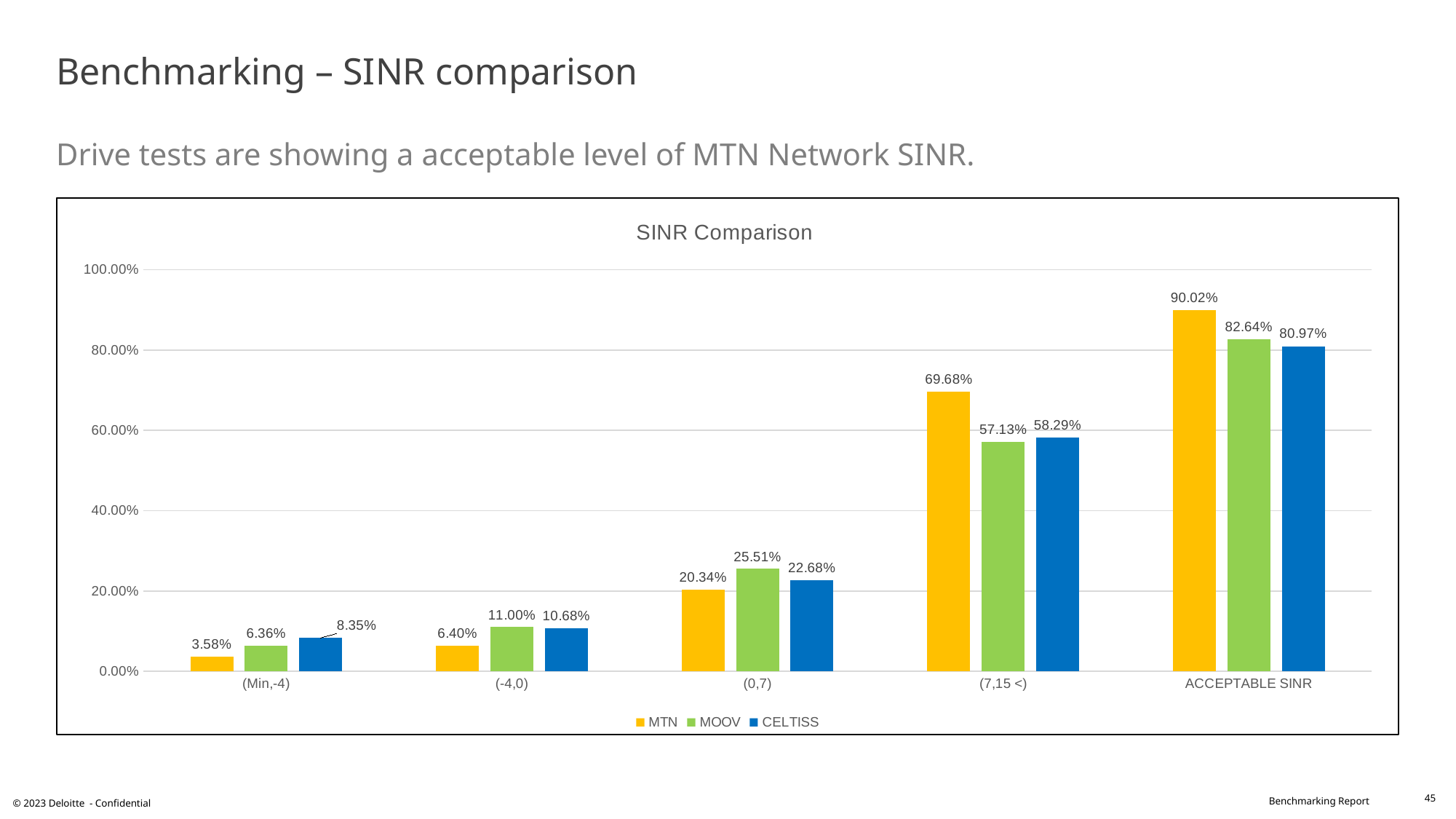
What is the title of the chart? SINR Comparison What is the value for MTN in the ACCEPTABLE SINR category? 90.02% How many series does the legend list? 3 What is the value for MOOV in the (0,7) category? 25.51% What kind of chart is shown on the slide? Bar chart Which series has the lowest value in the (-4,0) category? MTN Which series has the highest value in the (7,15 <) category? MTN What is the difference between the MTN and MOOV values in the ACCEPTABLE SINR category? 7.38% How many categories are shown on the x axis? 5 Is the value for MTN in the (7,15 <) category greater or less than 60.00%? greater Which is larger in the (7,15 <) category: the MOOV value or the CELTISS value? CELTISS What is the value for CELTISS in the (Min,-4) category? 8.35%